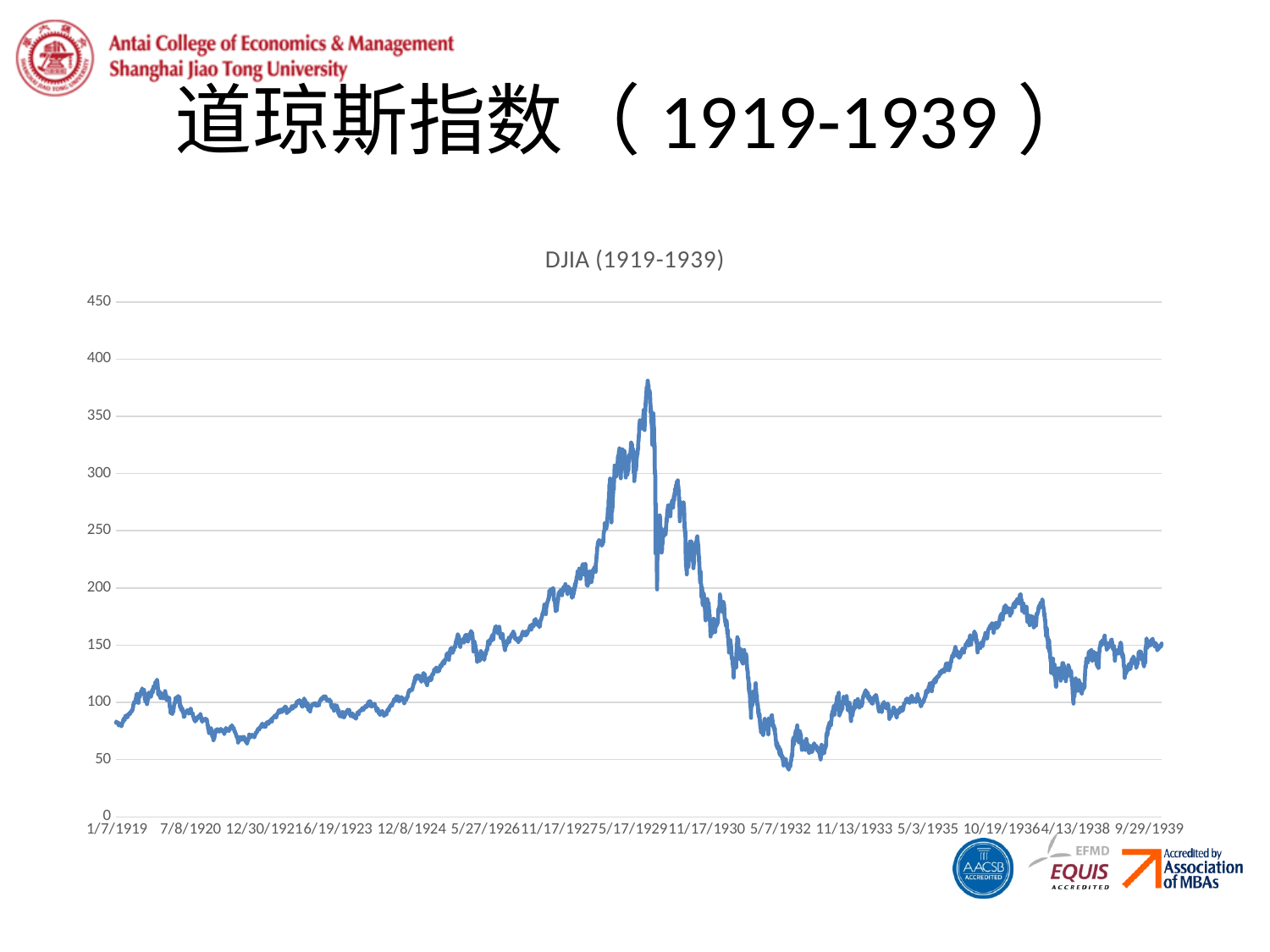
Is the value of the DJIA at the start of the series (1/7/1919) greater or less than 100? less Is the peak value of the DJIA line greater or less than 400? less What is the title of the chart? DJIA (1919-1939) Is the lowest value of the DJIA line, reached around 1932, greater or less than 50? less Does the DJIA line rise or fall between 1/7/1919 and its peak in 1929? rise What kind of chart is shown on the slide? line chart Does the DJIA line rise or fall between its 1929 peak and 5/7/1932? fall